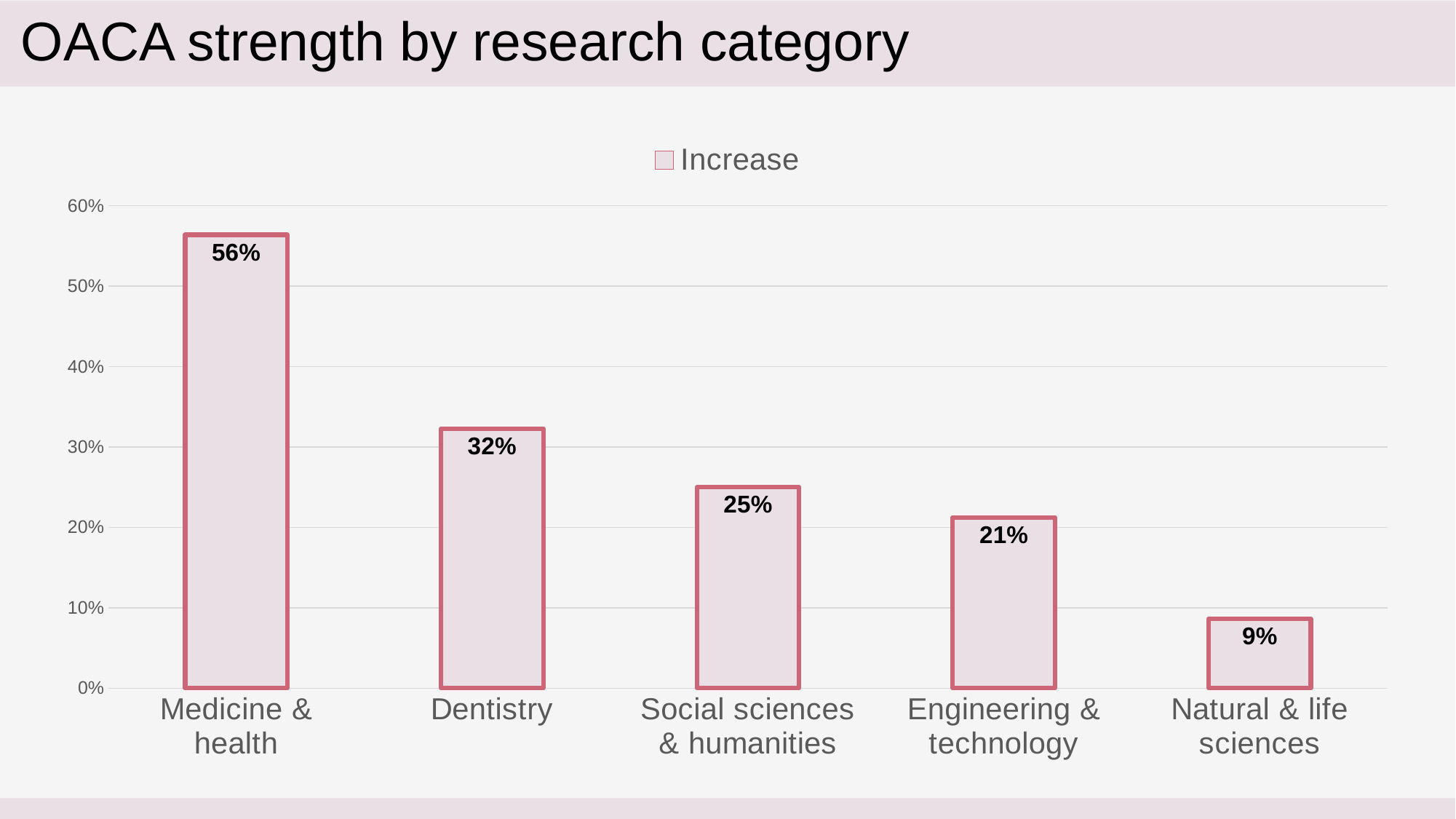
Which research category has the lowest value? Natural & life sciences Which research category has the highest value? Medicine & health Which is larger, the value for Social sciences & humanities or the value for Engineering & technology? Social sciences & humanities How many research categories are shown on the chart? 5 What is the difference between the values for Social sciences & humanities and Natural & life sciences? 16% What is the difference between the values for Medicine & health and Dentistry? 24% What is the value for Dentistry? 32% What is the name of the series listed in the legend? Increase What kind of chart is shown on the slide? bar chart Is the value for Dentistry greater or less than 30%? greater What is the value for Engineering & technology? 21% What is the value for Medicine & health? 56%